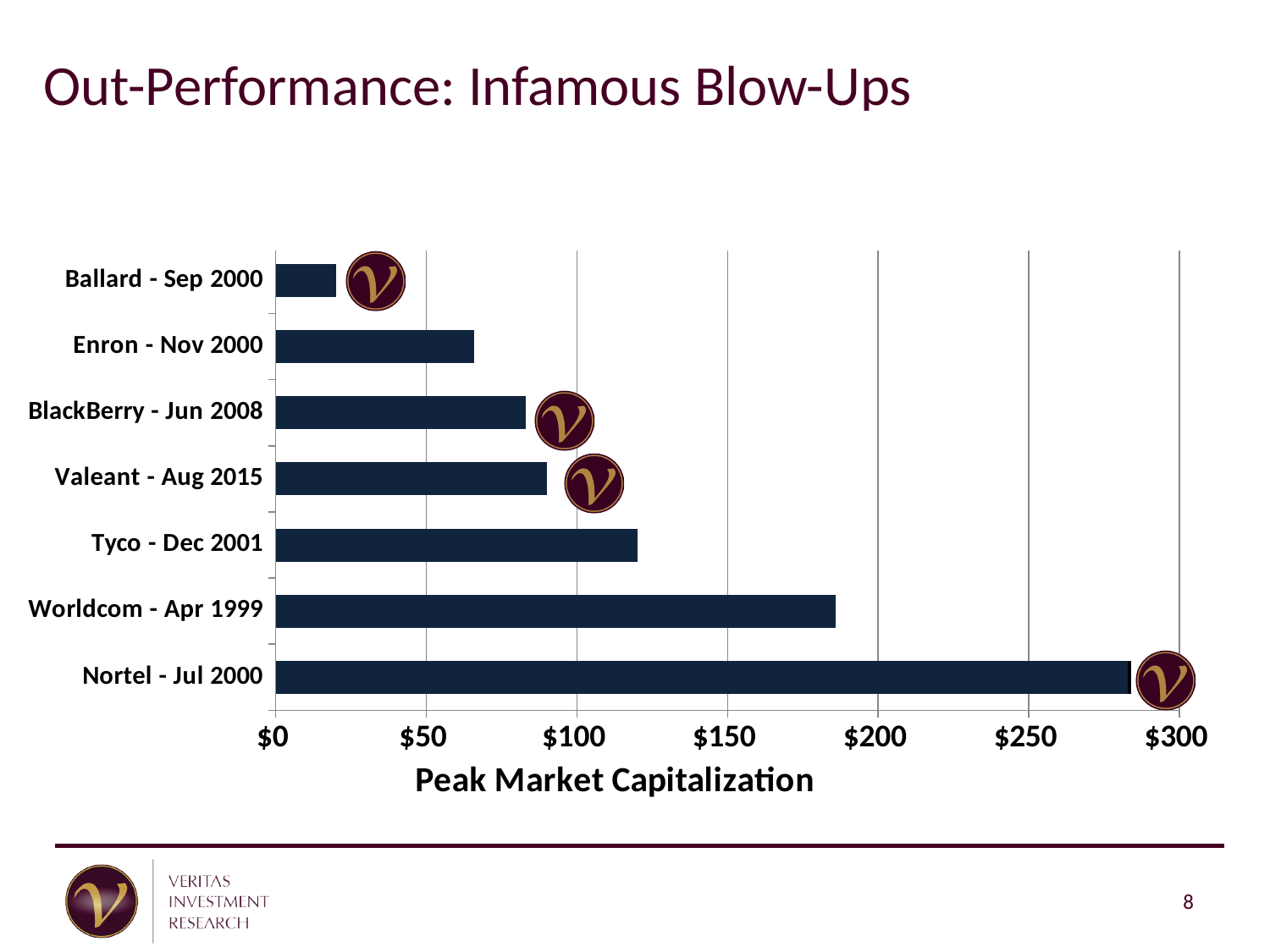
Is the value for Nortel - Jul 2000 greater or less than $250? greater Is the value for Worldcom - Apr 1999 greater or less than $150? greater How many companies are plotted in the chart? 7 Which has the larger peak market capitalization, Worldcom - Apr 1999 or Tyco - Dec 2001? Worldcom - Apr 1999 What is the maximum value shown on the horizontal axis of the chart? $300 Which company has the highest peak market capitalization in the chart? Nortel - Jul 2000 Is the value for Valeant - Aug 2015 greater or less than $100? less Which company has the lowest peak market capitalization in the chart? Ballard - Sep 2000 What is the title of the horizontal axis of the chart? Peak Market Capitalization What kind of chart is shown on the slide? bar chart Which has the larger peak market capitalization, Enron - Nov 2000 or BlackBerry - Jun 2008? BlackBerry - Jun 2008